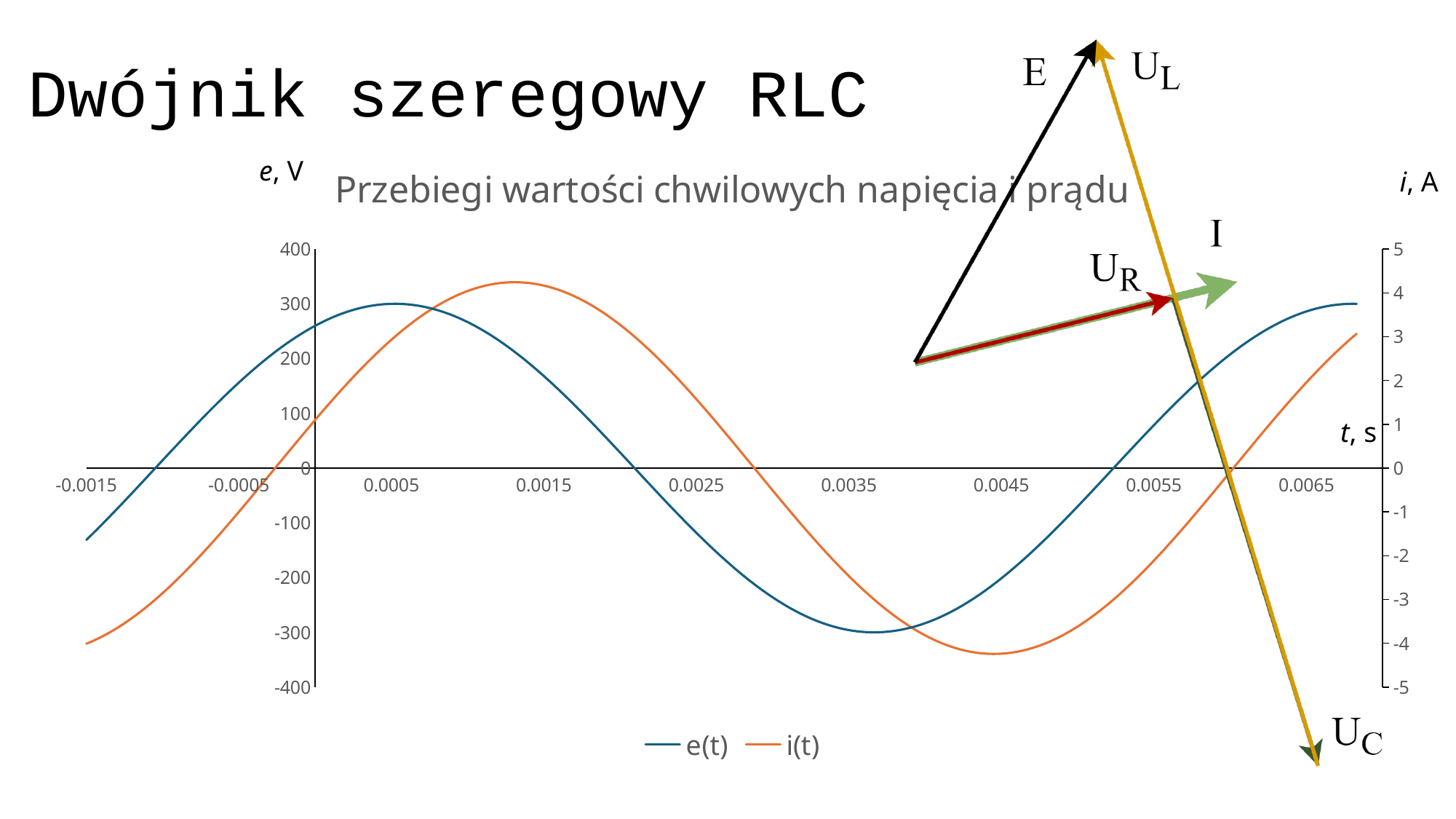
Does e(t) rise or fall between t = 0.0005 and t = 0.0025? fall Is the peak value of e(t) near t = 0.0005 greater or less than 200 on the left axis? greater What are the two series named in the chart legend? e(t) and i(t) Does e(t) rise or fall between t = 0.0035 and t = 0.0065? rise Is the peak value of i(t) near t = 0.0015 greater or less than 3 on the right axis? greater How many series does the chart legend list? 2 Which curve reaches a higher point on the plot area, e(t) or i(t)? i(t) What is the title of the chart? Przebiegi wartości chwilowych napięcia i prądu What kind of chart is shown on the slide? line chart Is the value of e(t) at t = 0.0035 greater or less than -200 on the left axis? less Does i(t) rise or fall between t = -0.0015 and t = 0.0015? rise